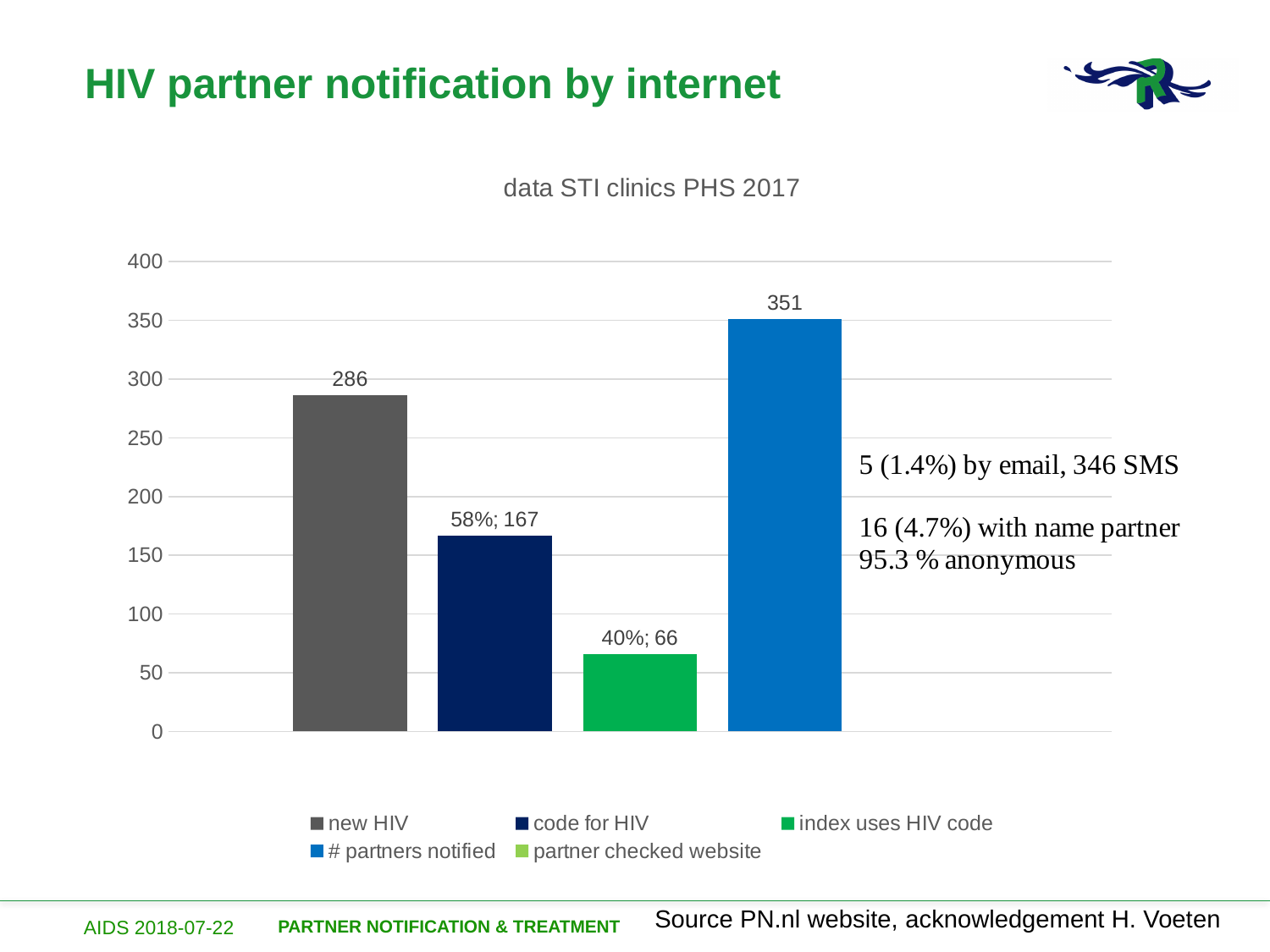
What is the data label on the 'index uses HIV code' bar? 40%; 66 What kind of chart is shown on the slide? bar chart Which series has the shortest bar? index uses HIV code Which is larger, the 'new HIV' bar or the 'code for HIV' bar? new HIV What is the data label on the '# partners notified' bar? 351 What is the data label on the 'code for HIV' bar? 58%; 167 Which series has the tallest bar? # partners notified What is the value of the 'new HIV' bar? 286 What is the difference between the '# partners notified' value and the 'new HIV' value? 65 How many bars are plotted in the chart? 4 What is the title of the chart? data STI clinics PHS 2017 How many series does the legend list? 5